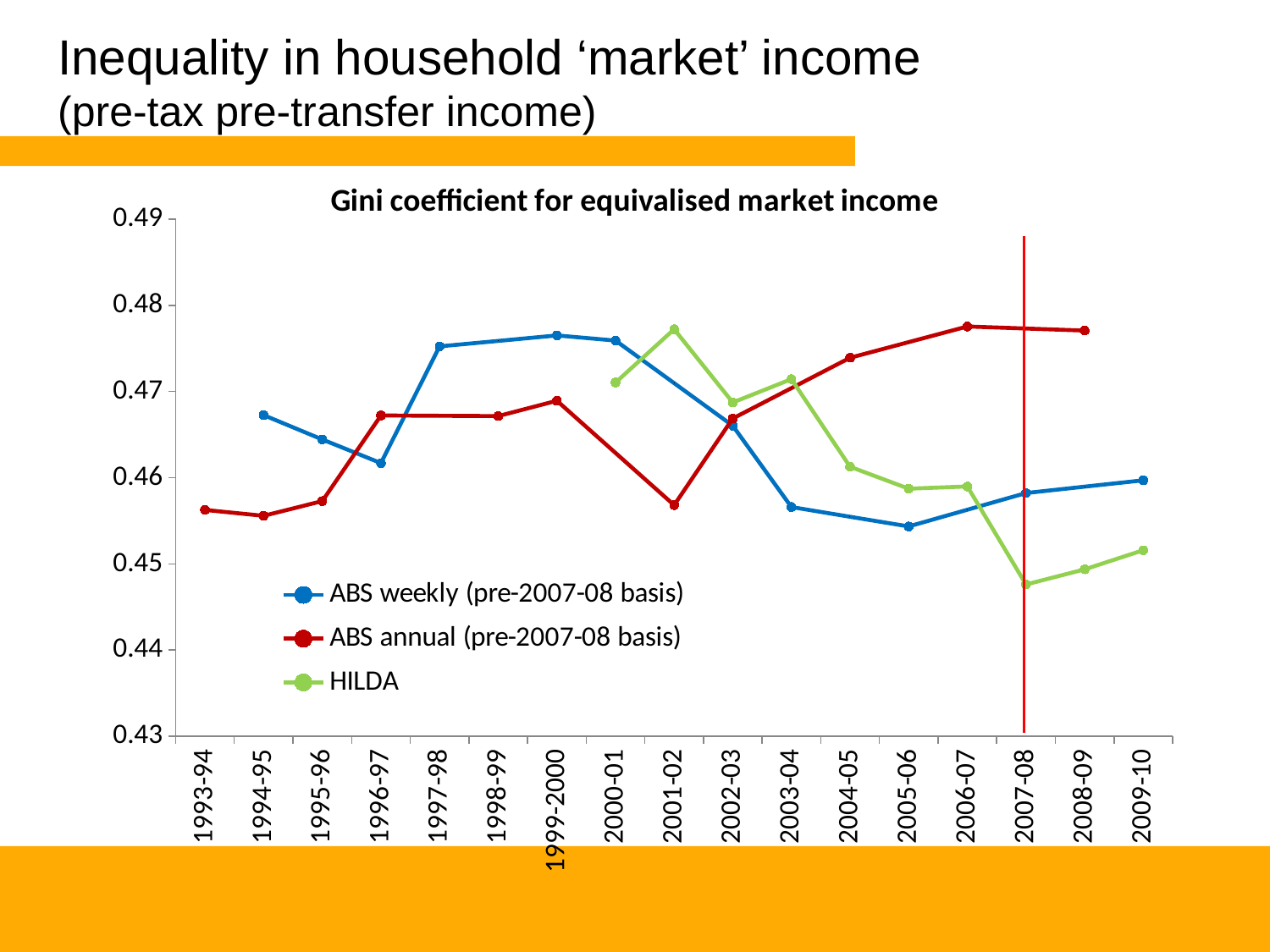
Is the ABS annual (pre-2007-08 basis) value for 1993-94 greater or less than 0.46? less In which year does the HILDA series reach its lowest value? 2007-08 What kind of chart is shown on the slide? line chart Does the HILDA series rise or fall from 2007-08 to 2009-10? rise In 1999-2000, which is larger: the ABS weekly value or the ABS annual value? ABS weekly (pre-2007-08 basis) Which series has the highest value in 2008-09? ABS annual (pre-2007-08 basis) Is the HILDA value for 2007-08 greater or less than 0.45? less What is the title of the chart? Gini coefficient for equivalised market income How many series does the legend list? 3 Is the ABS weekly (pre-2007-08 basis) value for 2005-06 greater or less than 0.46? less How many financial years are shown along the x axis? 17